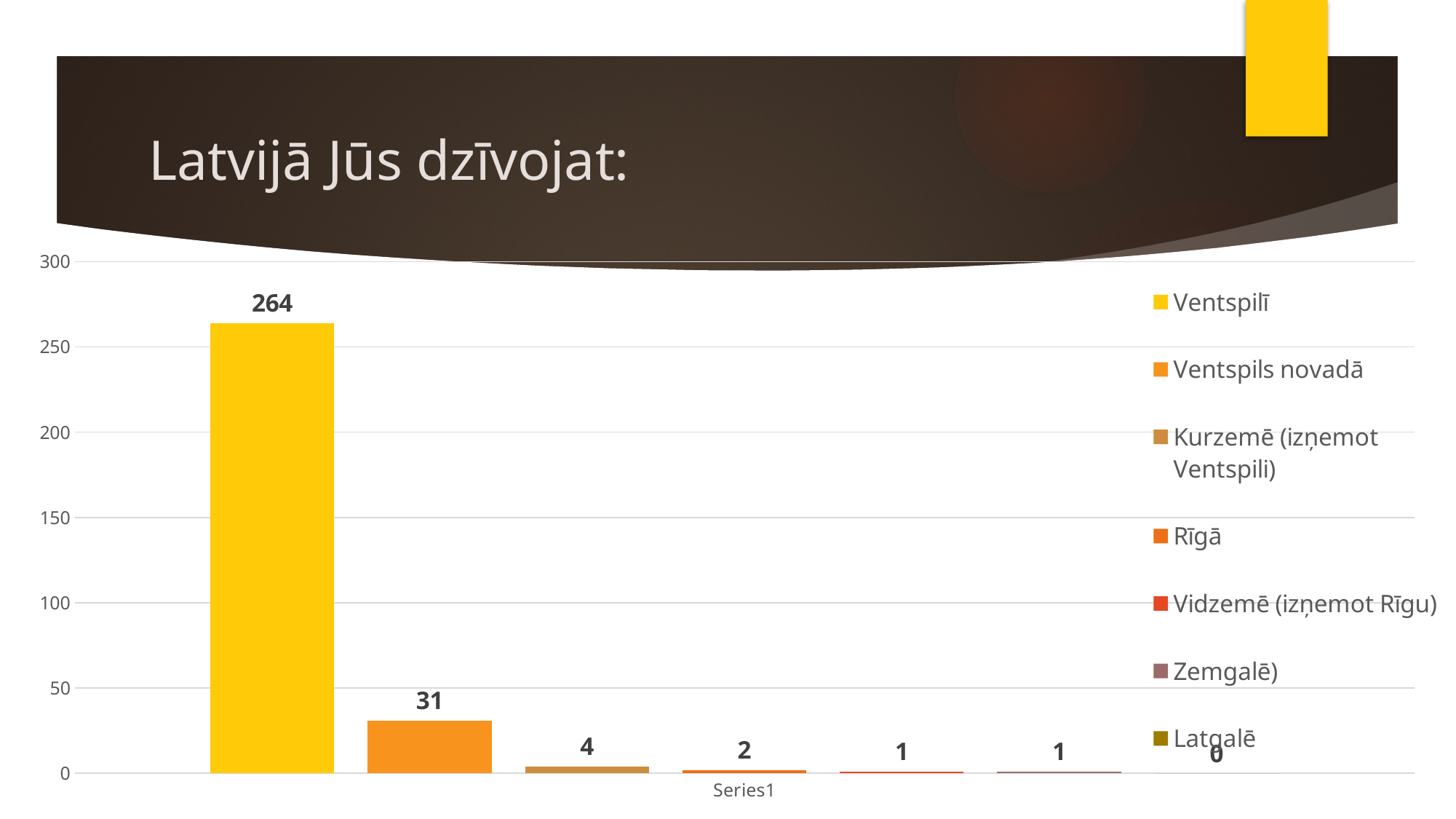
What value is shown for Kurzemē (izņemot Ventspili)? 4 Which category has the highest value? Ventspilī What value is shown for Ventspils novadā? 31 What value is shown for Ventspilī? 264 What value is shown for Rīgā? 2 What is the difference between the values for Ventspilī and Ventspils novadā? 233 How many entries does the legend list? 7 What value is shown for Latgalē? 0 Is the value for Ventspilī greater or less than 250? greater What kind of chart is shown on the slide? bar chart Which category has the lowest value? Latgalē Which is larger, the value for Ventspils novadā or the value for Rīgā? Ventspils novadā